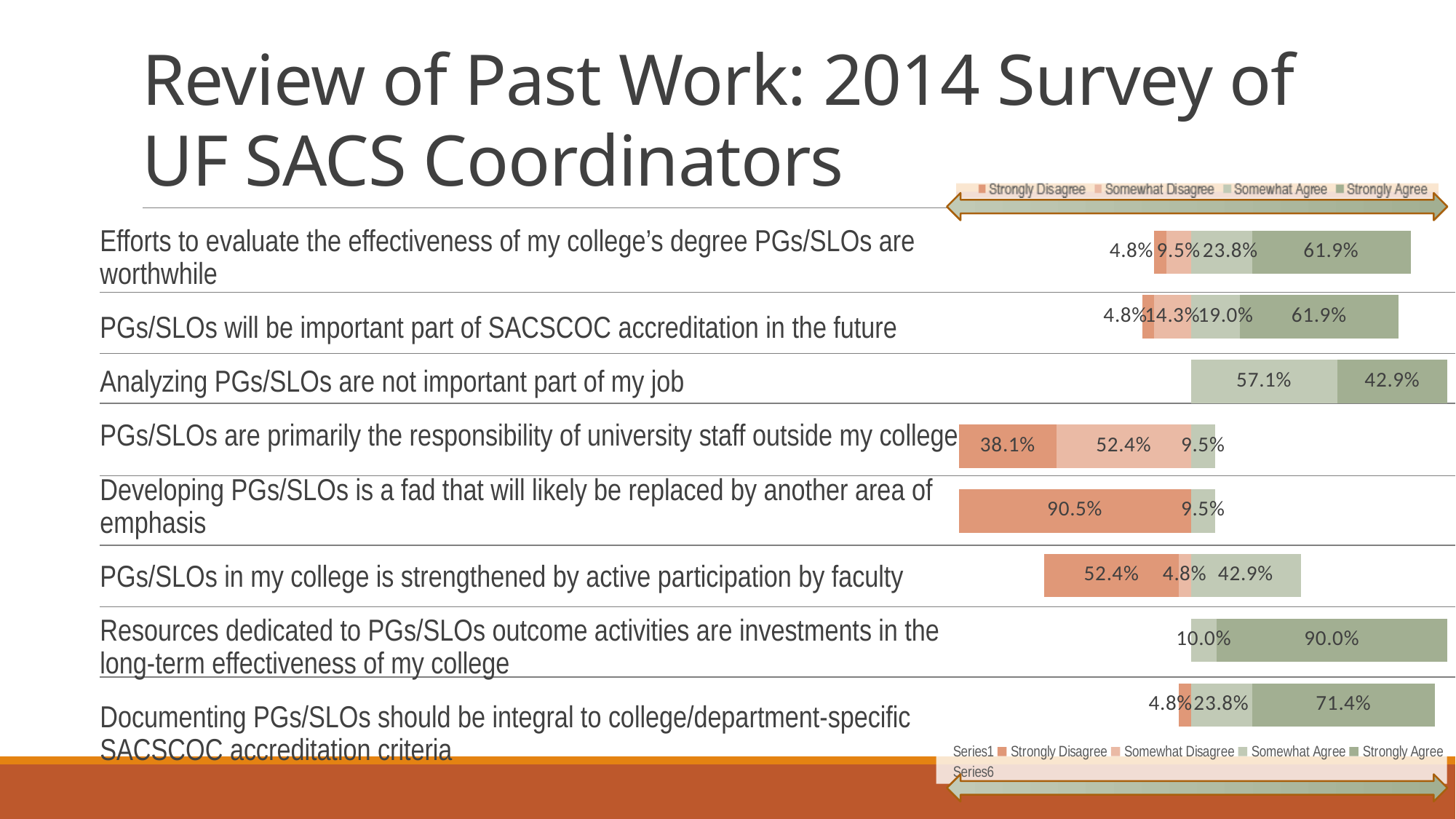
Which statement has the larger Strongly Disagree share: that developing PGs/SLOs is a fad, or that PGs/SLOs are primarily the responsibility of university staff outside the college? Developing PGs/SLOs is a fad that will likely be replaced by another area of emphasis How many survey statements are plotted in the chart? 8 What kind of chart is used to show the survey results? Stacked bar chart What percentage somewhat disagreed that PGs/SLOs are primarily the responsibility of university staff outside their college? 52.4% What percentage somewhat disagreed that PGs/SLOs will be an important part of SACSCOC accreditation in the future? 14.3% For the statement that efforts to evaluate the effectiveness of degree PGs/SLOs are worthwhile, how many percentage points higher is Strongly Agree than Somewhat Agree? 38.1 percentage points For the statement that analyzing PGs/SLOs is not an important part of my job, what is the combined Somewhat Agree and Strongly Agree percentage? 100.0% What percentage strongly disagreed that developing PGs/SLOs is a fad that will likely be replaced by another area of emphasis? 90.5% Which statement received the highest Strongly Agree percentage? Resources dedicated to PGs/SLOs outcome activities are investments in the long-term effectiveness of my college What percentage of respondents strongly agreed that resources dedicated to PGs/SLOs outcome activities are investments in the long-term effectiveness of their college? 90.0% How many response categories does the legend at the top of the chart list? 4 What percentage strongly agreed that documenting PGs/SLOs should be integral to college/department-specific SACSCOC accreditation criteria? 71.4%